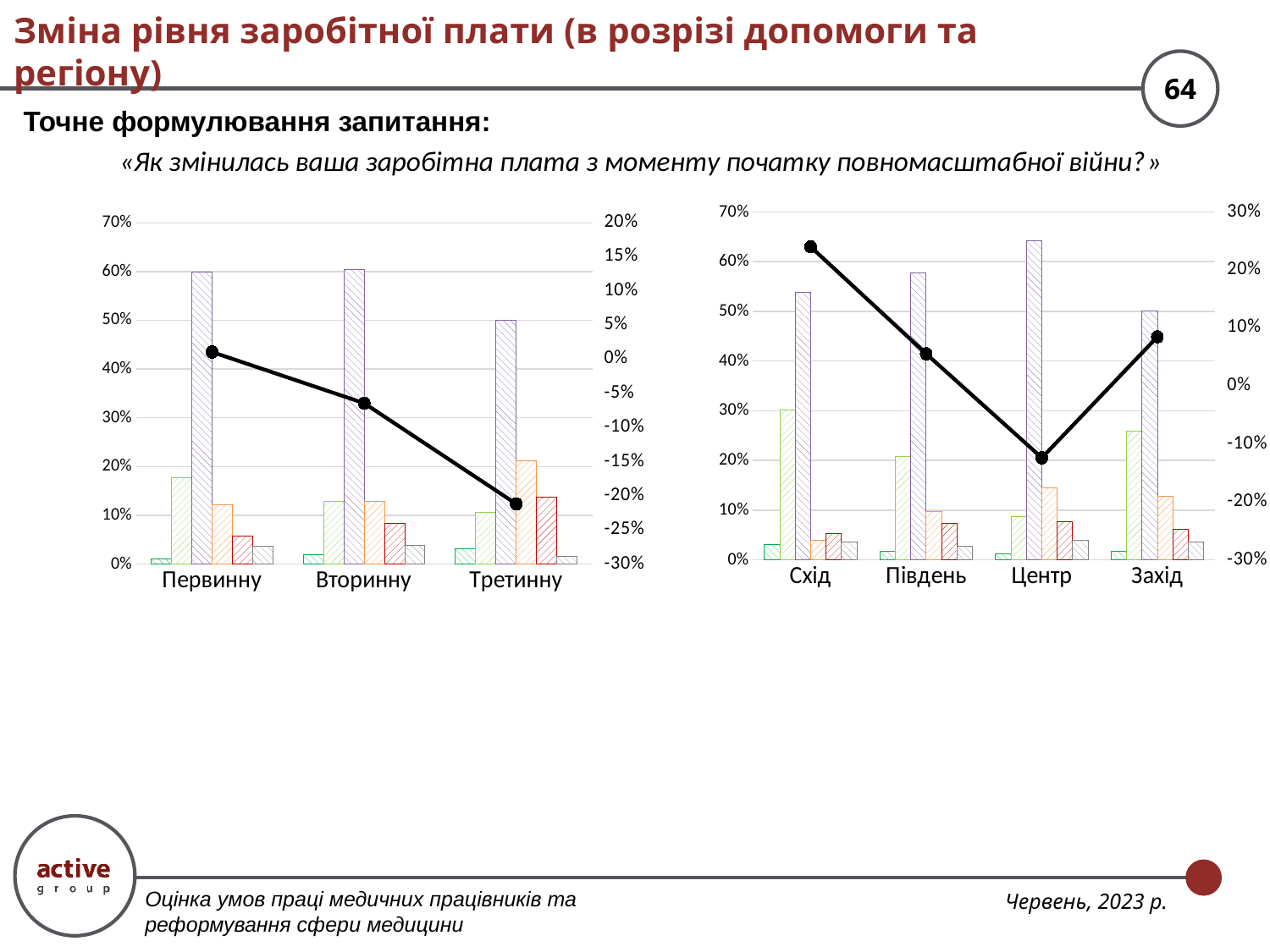
How many charts are shown on the slide? 2 In the right chart, which region has the lowest point on the black line? Центр In the right chart, is the black line value for Центр (right axis) greater or less than 0%? less How many categories are shown on the x axis of the left chart? 3 In the left chart, is the tallest bar for Первинну greater or less than 50%? greater What kind of chart is the left chart (with categories Первинну, Вторинну, Третинну)? A combined bar and line chart In the left chart, does the black line rise or fall from Первинну to Третинну? It falls How many regions are shown on the x axis of the right chart? 4 In the right chart, which region has the tallest bar? Центр In the left chart, is the black line value for Третинну (right axis) greater or less than -10%? less In the right chart, which region has the highest point on the black line? Схід